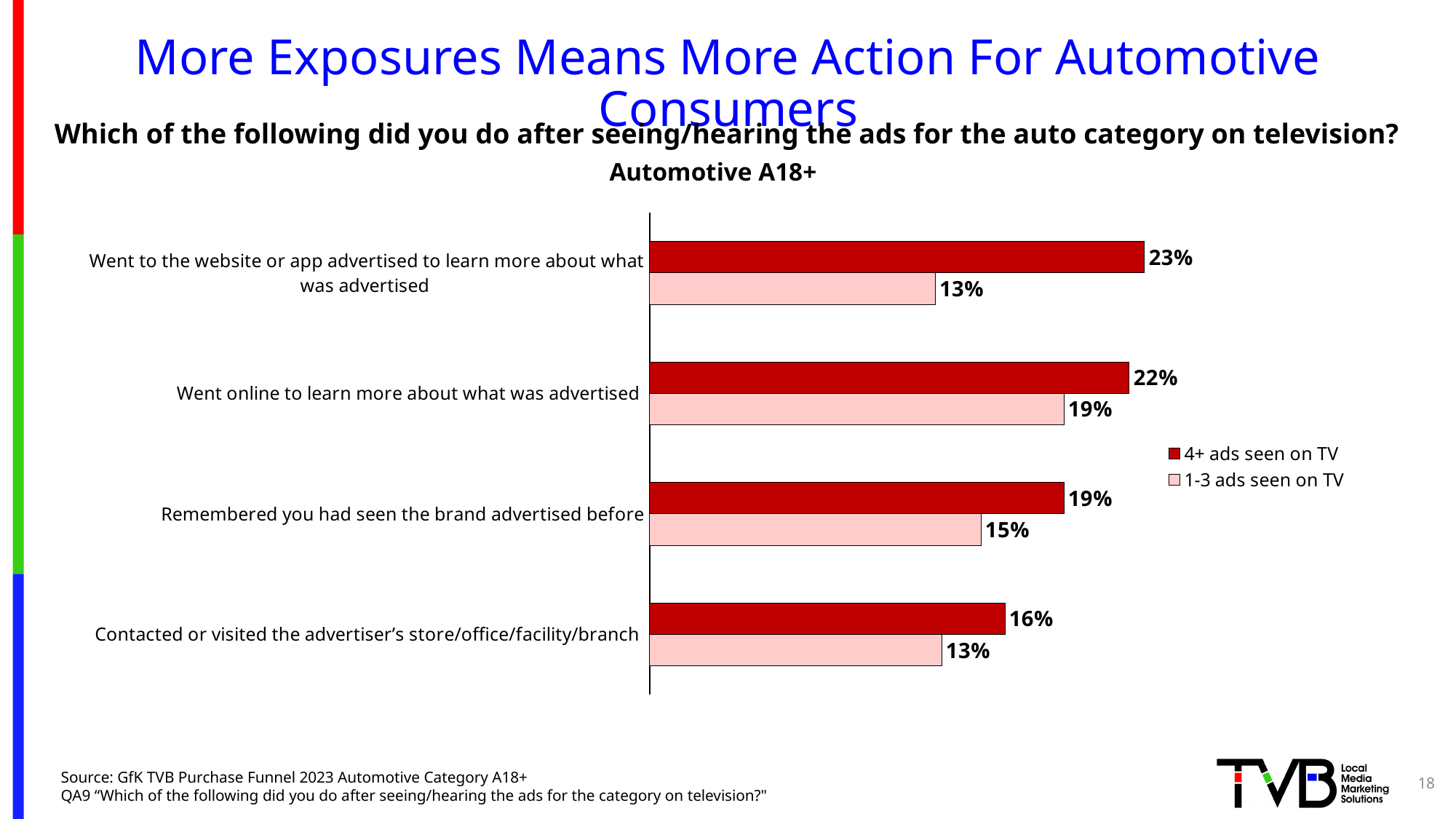
What type of chart is shown on the slide? Bar chart What is the value for 'Contacted or visited the advertiser's store/office/facility/branch' among those who saw 4+ ads on TV? 16% Which action has the lowest value for the '4+ ads seen on TV' series? Contacted or visited the advertiser's store/office/facility/branch What percentage of the '1-3 ads seen on TV' group went online to learn more about what was advertised? 19% What percentage of the '4+ ads seen on TV' group went to the website or app advertised to learn more about what was advertised? 23% For 'Remembered you had seen the brand advertised before', which group has the larger value: 4+ ads seen on TV or 1-3 ads seen on TV? 4+ ads seen on TV What is the value for 'Remembered you had seen the brand advertised before' among those who saw 1-3 ads on TV? 15% What is the difference between the 4+ ads and 1-3 ads values for 'Went online to learn more about what was advertised'? 3 percentage points Which action has the highest value for the '4+ ads seen on TV' series? Went to the website or app advertised to learn more about what was advertised How many series does the legend list? 2 What is the difference between the 4+ ads and 1-3 ads values for 'Went to the website or app advertised to learn more about what was advertised'? 10 percentage points How many action categories are shown in the chart? 4